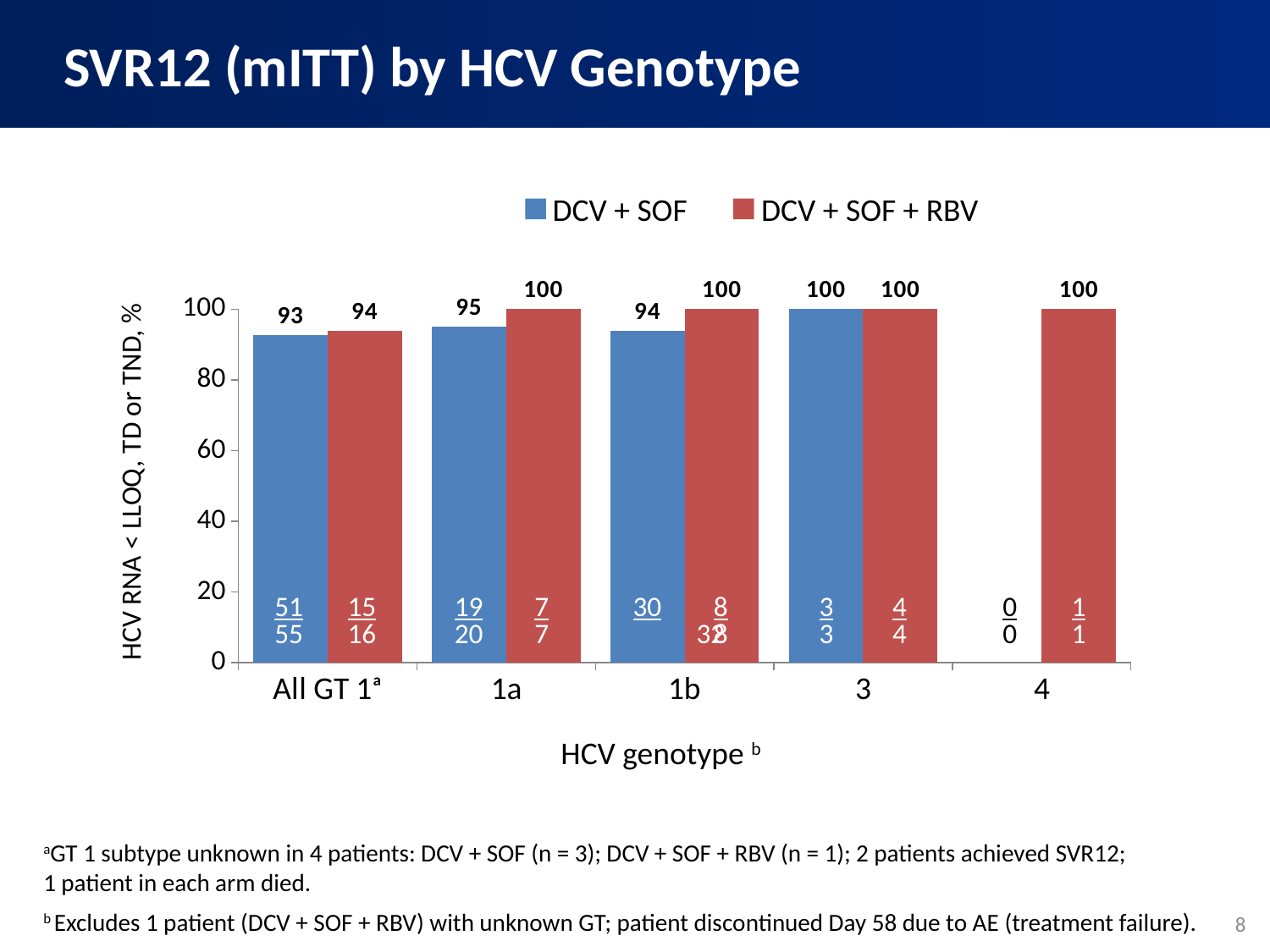
What kind of chart is shown on the slide? Bar chart What is the difference between the DCV + SOF + RBV and DCV + SOF values in genotype 1a? 5 How many genotype categories are shown on the x axis? 5 What is the label of the y axis? HCV RNA < LLOQ, TD or TND, % What is the SVR12 value for DCV + SOF in the All GT 1 group? 93 In genotype 1b, which arm has the higher SVR12 value, DCV + SOF or DCV + SOF + RBV? DCV + SOF + RBV What is the title of the slide's chart? SVR12 (mITT) by HCV Genotype Which genotype category has the lowest SVR12 value for DCV + SOF? All GT 1 What is the SVR12 value for DCV + SOF + RBV in the All GT 1 group? 94 What is the SVR12 value for DCV + SOF + RBV in genotype 1a? 100 What is the SVR12 value for DCV + SOF in genotype 1b? 94 How many series does the legend list? 2